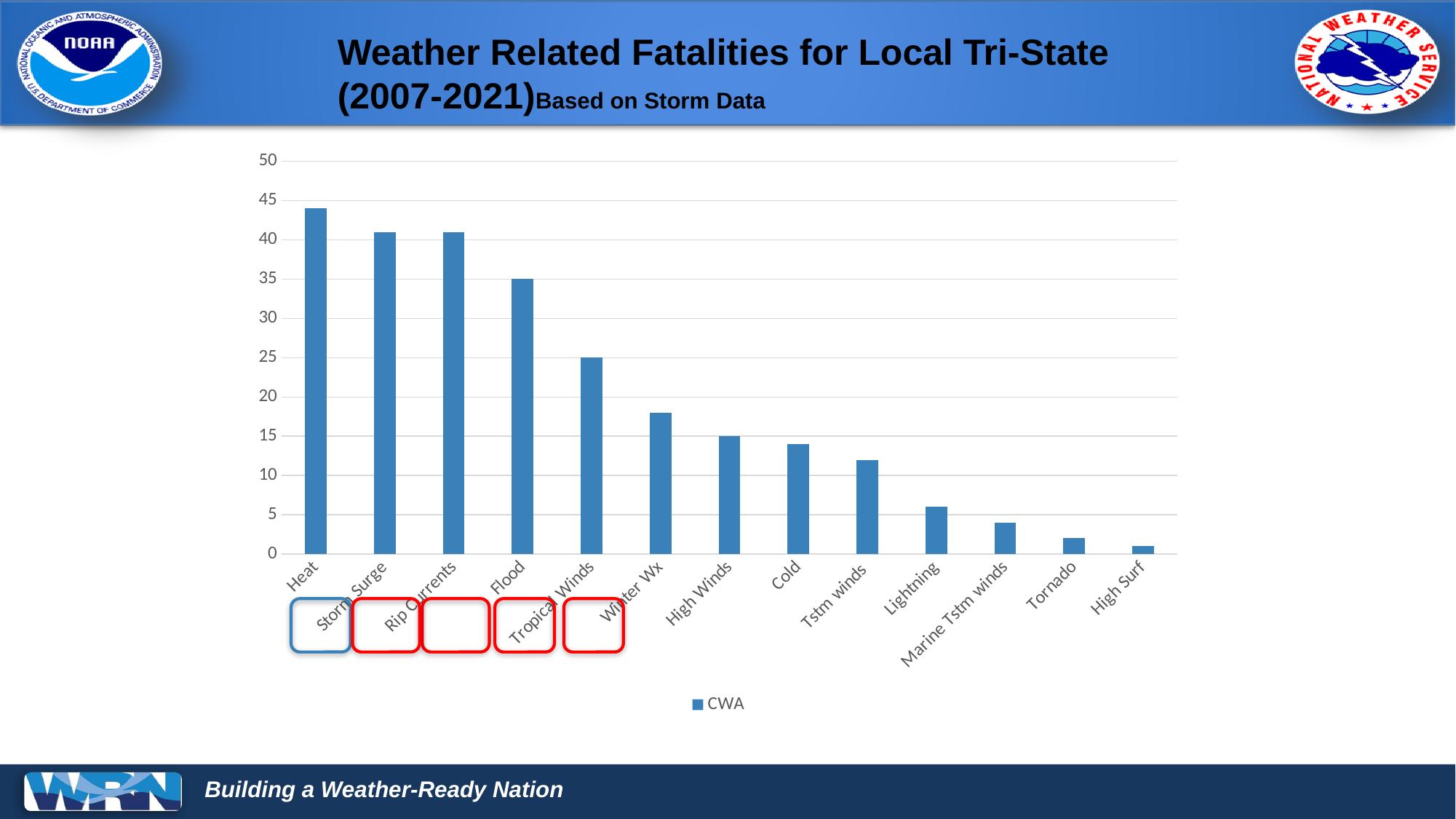
What is the value for High Winds? 15 Is the value for Heat greater or less than 40? greater What kind of chart is shown on the slide? bar chart What is the value for Flood? 35 How many series does the legend list? 1 Do the values rise or fall moving from left to right along the x axis? fall Which is larger, the value for Cold or the value for Lightning? Cold Which category has the lowest number of fatalities? High Surf How many categories are plotted on the x axis? 13 What is the value for Tropical Winds? 25 Is the value for Lightning greater or less than 10? less Which category has the highest number of fatalities? Heat